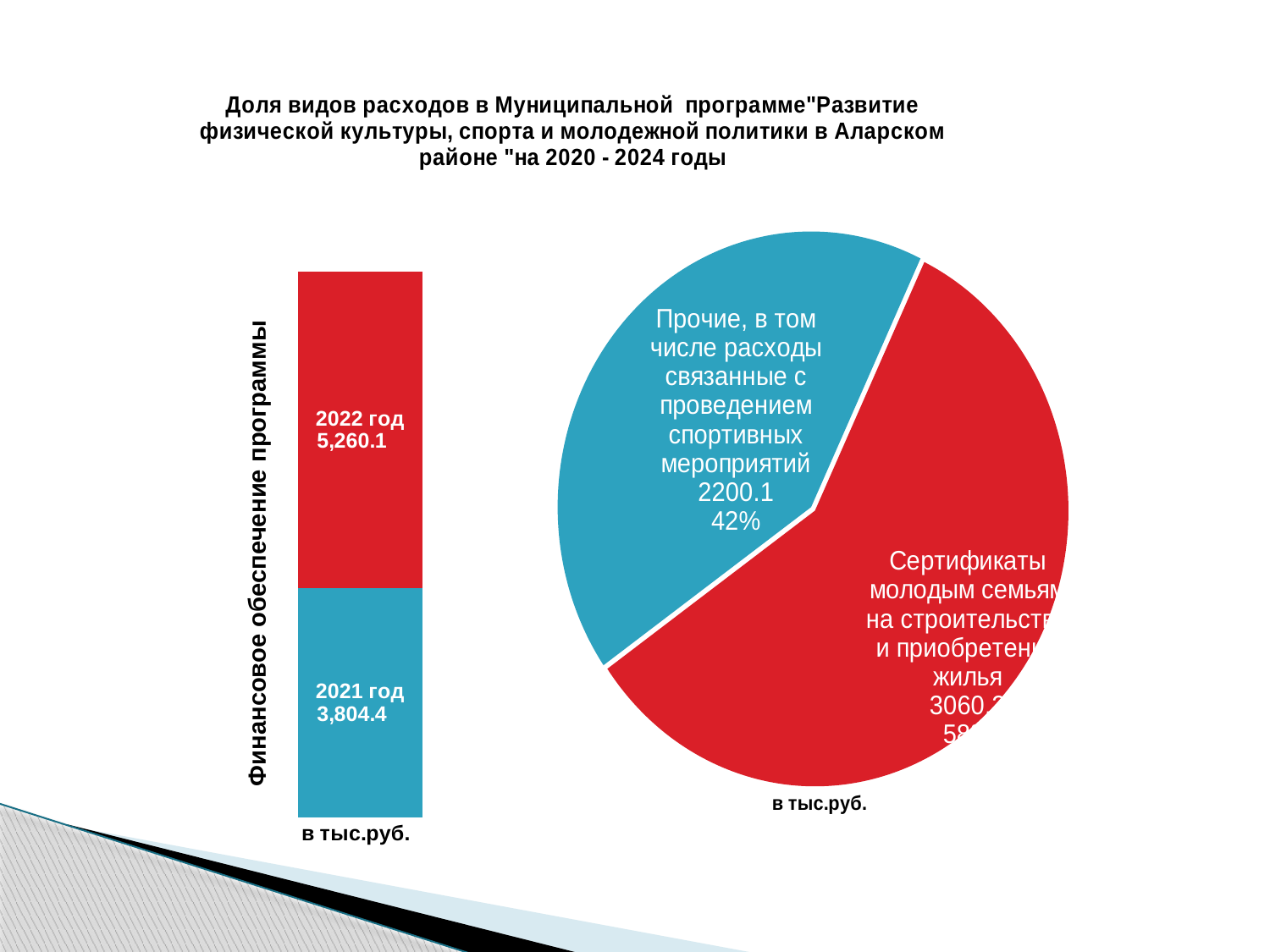
In the stacked bar chart on the left, which year has the larger value, 2021 год or 2022 год? 2022 год In the stacked bar chart on the left, how many segments make up the bar? 2 What kind of chart is shown on the right of the slide? Pie chart What kind of chart is shown on the left of the slide? Stacked bar chart In the pie chart on the right, which slice is larger: the blue 'Прочие' slice or the red 'Сертификаты молодым семьям' slice? Сертификаты молодым семьям In the stacked bar chart on the left, what is the value for 2022 год? 5,260.1 In the pie chart on the right, what value is shown for the slice 'Прочие, в том числе расходы связанные с проведением спортивных мероприятий'? 2200.1 In the stacked bar chart on the left, what is the value for 2021 год? 3,804.4 In the pie chart on the right, what share of the pie is the slice 'Прочие, в том числе расходы связанные с проведением спортивных мероприятий'? 42% In the stacked bar chart on the left, what is the total of the two stacked segments? 9,064.5 In the stacked bar chart on the left, what is the difference between the 2022 год and 2021 год values? 1,455.7 In the stacked bar chart on the left, what is the label on the vertical axis? Финансовое обеспечение программы